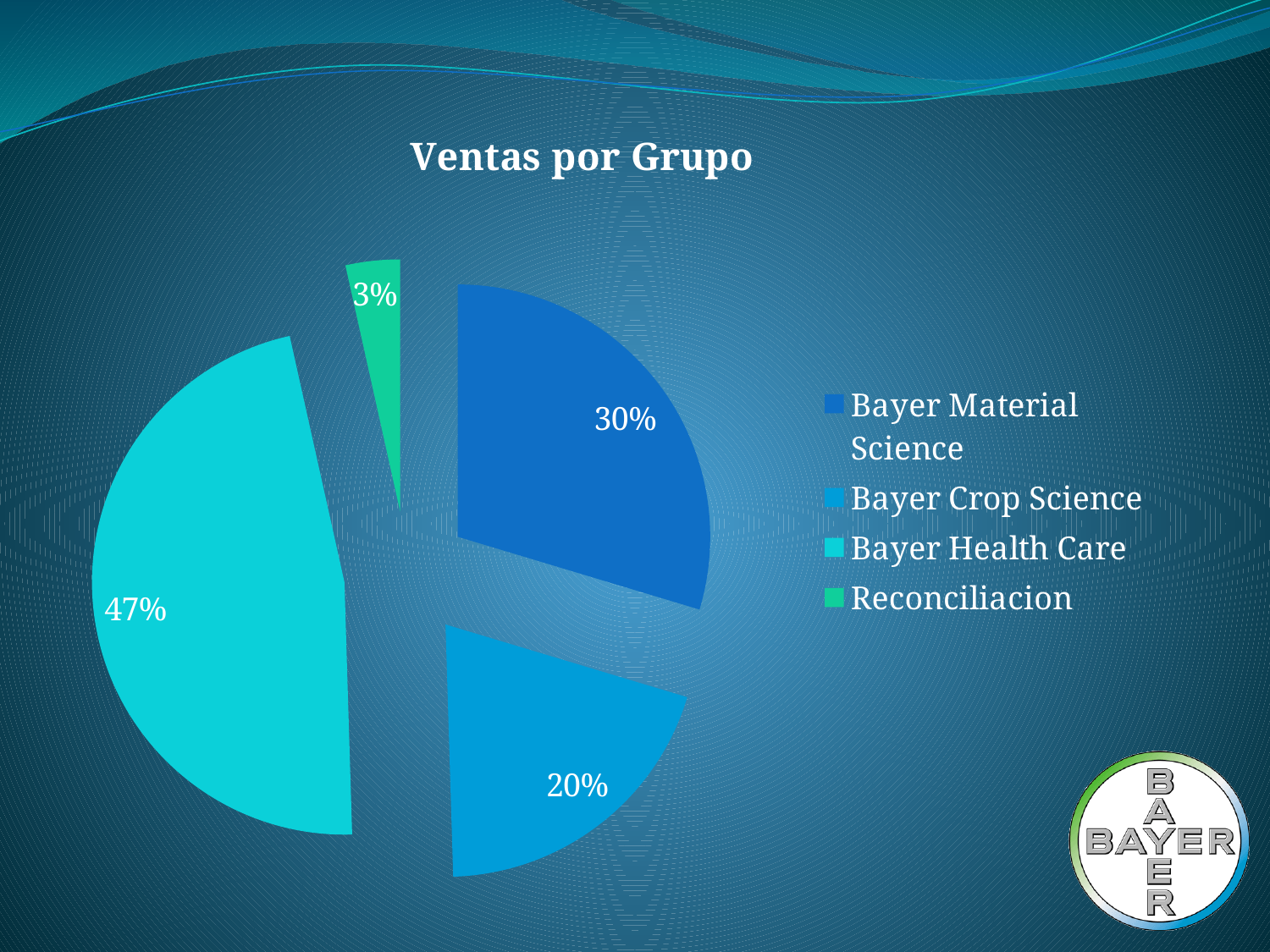
What share of the pie does Bayer Health Care have? 47% What kind of chart is shown on the slide? Pie chart Which group has the smallest share of sales? Reconciliacion What share of the pie does Bayer Material Science have? 30% What is the title of the chart? Ventas por Grupo What is the difference in percentage points between Bayer Health Care and Bayer Material Science? 17 Which is larger, the share for Bayer Material Science or the share for Bayer Crop Science? Bayer Material Science What share of the pie does Reconciliacion have? 3% Which group has the largest share of sales? Bayer Health Care What share of the pie does Bayer Crop Science have? 20% How many entries does the legend list? 4 How many slices does the pie chart have? 4